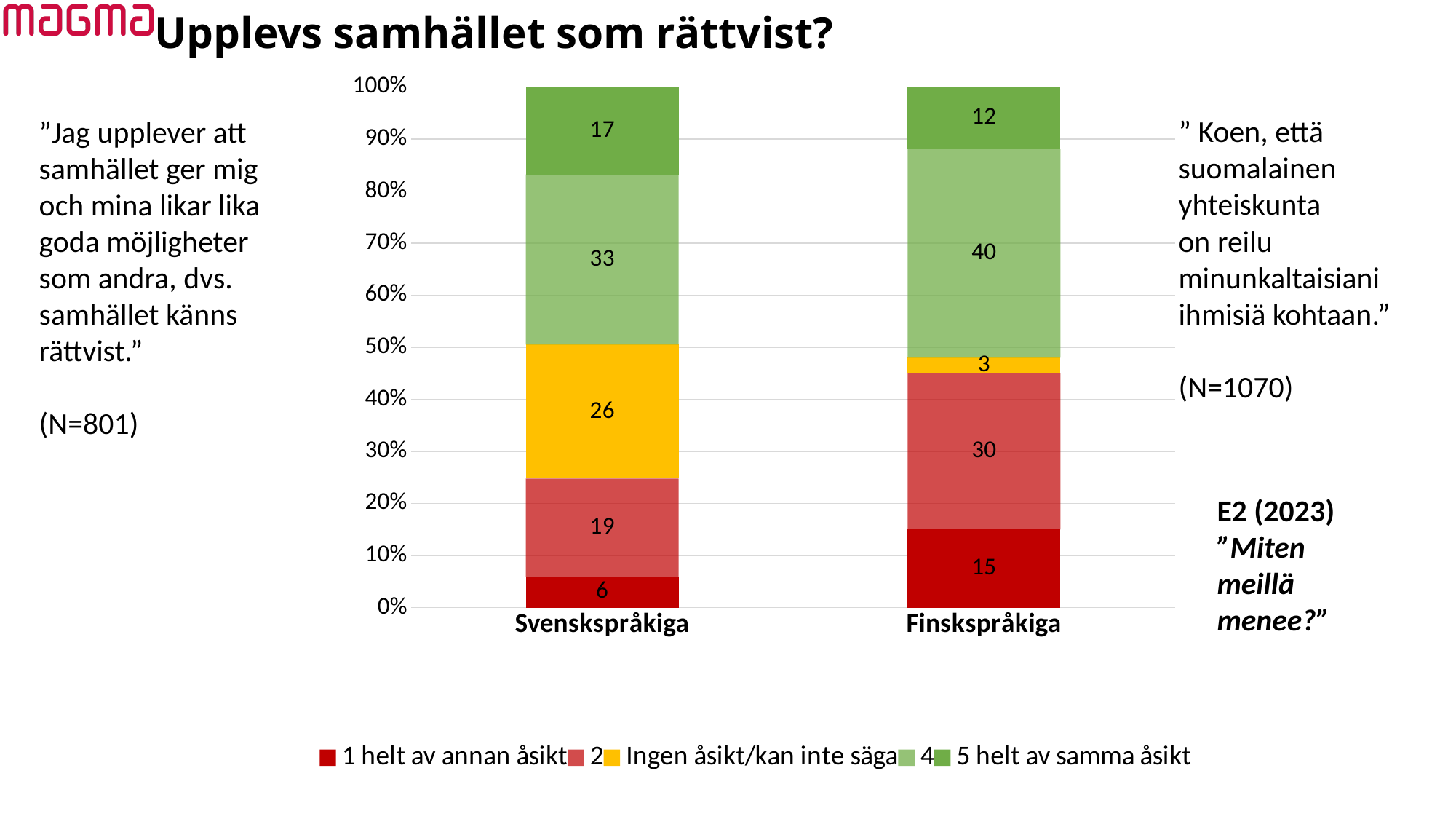
What is the value for '5 helt av samma åsikt' for Svenskspråkiga? 17 What is the value for series '2' for Svenskspråkiga? 19 What is the value for 'Ingen åsikt/kan inte säga' for Svenskspråkiga? 26 What is the title of the slide? Upplevs samhället som rättvist? How many categories are shown on the x axis? 2 What is the difference between the '1 helt av annan åsikt' values for Finskspråkiga and Svenskspråkiga? 9 What kind of chart is shown? Stacked bar chart What is the value for series '4' for Finskspråkiga? 40 What is the difference between the series '4' values for Finskspråkiga and Svenskspråkiga? 7 Which category has the higher value for 'Ingen åsikt/kan inte säga', Svenskspråkiga or Finskspråkiga? Svenskspråkiga How many series does the legend list? 5 What is the value for '1 helt av annan åsikt' for Finskspråkiga? 15